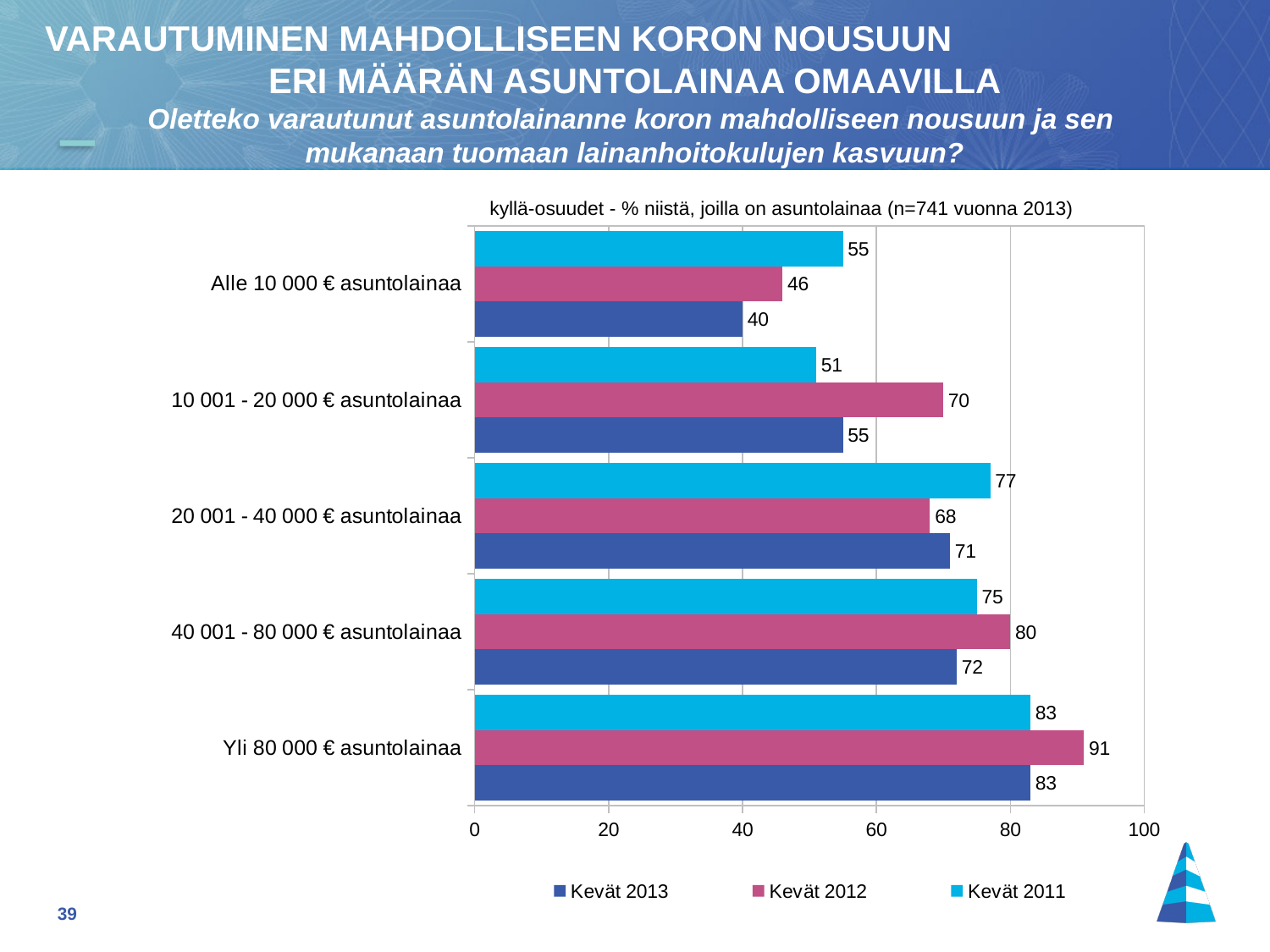
Which series is shown in pink on the chart? Kevät 2012 What is the difference between the Kevät 2012 and Kevät 2013 values for 'Yli 80 000 € asuntolainaa'? 8 Is the Kevät 2011 value for '10 001 - 20 000 € asuntolainaa' greater or less than 60? less Which category has the lowest Kevät 2013 value? Alle 10 000 € asuntolainaa What is the Kevät 2013 value for 'Alle 10 000 € asuntolainaa'? 40 For '40 001 - 80 000 € asuntolainaa', which is larger: the Kevät 2012 value or the Kevät 2011 value? Kevät 2012 What is the Kevät 2011 value for '20 001 - 40 000 € asuntolainaa'? 77 How many loan-size categories are shown on the chart? 5 What is the Kevät 2012 value for '10 001 - 20 000 € asuntolainaa'? 70 Which category has the highest Kevät 2012 value? Yli 80 000 € asuntolainaa How many series does the legend list? 3 What kind of chart is shown on the slide? Bar chart